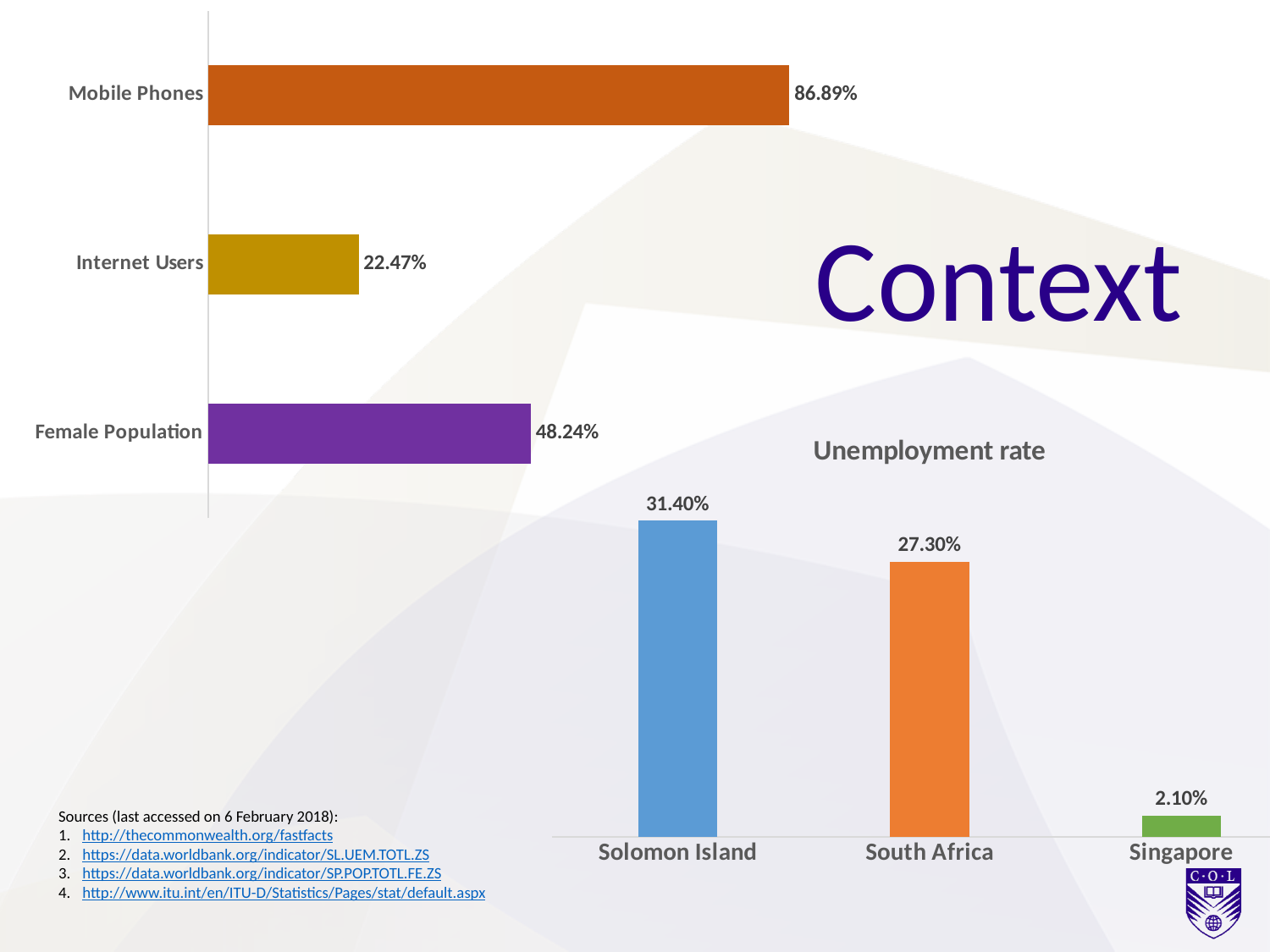
In the horizontal bar chart on the left of the slide, which category has the lowest value? Internet Users In the Unemployment rate chart, which is larger, the value for South Africa or the value for Singapore? South Africa In the horizontal bar chart on the left of the slide, what is the difference between the Mobile Phones value and the Internet Users value? 64.42% In the Unemployment rate chart, what is the unemployment rate for South Africa? 27.30% In the Unemployment rate chart, what is the unemployment rate for Singapore? 2.10% In the horizontal bar chart on the left of the slide, what is the value for Female Population? 48.24% In the horizontal bar chart on the left of the slide, what is the value for Mobile Phones? 86.89% In the Unemployment rate chart, which country has the highest unemployment rate? Solomon Island In the horizontal bar chart on the left of the slide, how many categories are shown? 3 What kind of chart is the Unemployment rate chart? Bar chart In the horizontal bar chart on the left of the slide, what is the value for Internet Users? 22.47% In the Unemployment rate chart, what is the difference between the unemployment rates of Solomon Island and South Africa? 4.10%